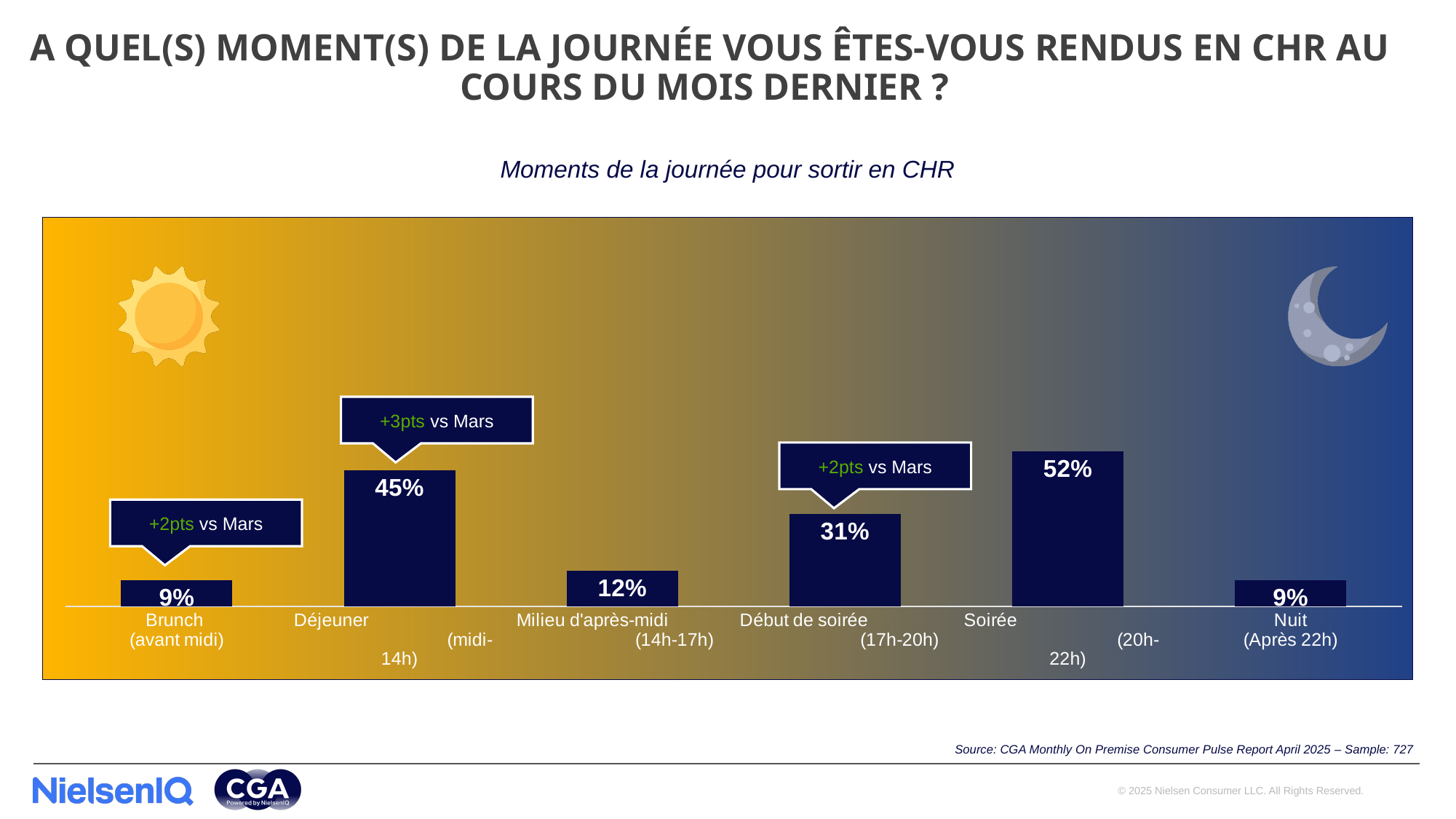
What is the value for Début de soirée (17h-20h)? 31% How many moments of the day are shown on the chart? 6 What kind of chart is shown on the slide? Bar chart What is the difference between the values for Soirée and Déjeuner? 7% What is the title of the chart? Moments de la journée pour sortir en CHR Which is larger, the value for Déjeuner or the value for Début de soirée? Déjeuner What is the value for Déjeuner (midi-14h)? 45% Which moment of the day has the highest value? Soirée (20h-22h) What is the value for Soirée (20h-22h)? 52% What is the change vs Mars shown for Déjeuner? +3pts What is the difference between the values for Début de soirée and Milieu d'après-midi? 19% What is the value for Milieu d'après-midi (14h-17h)? 12%